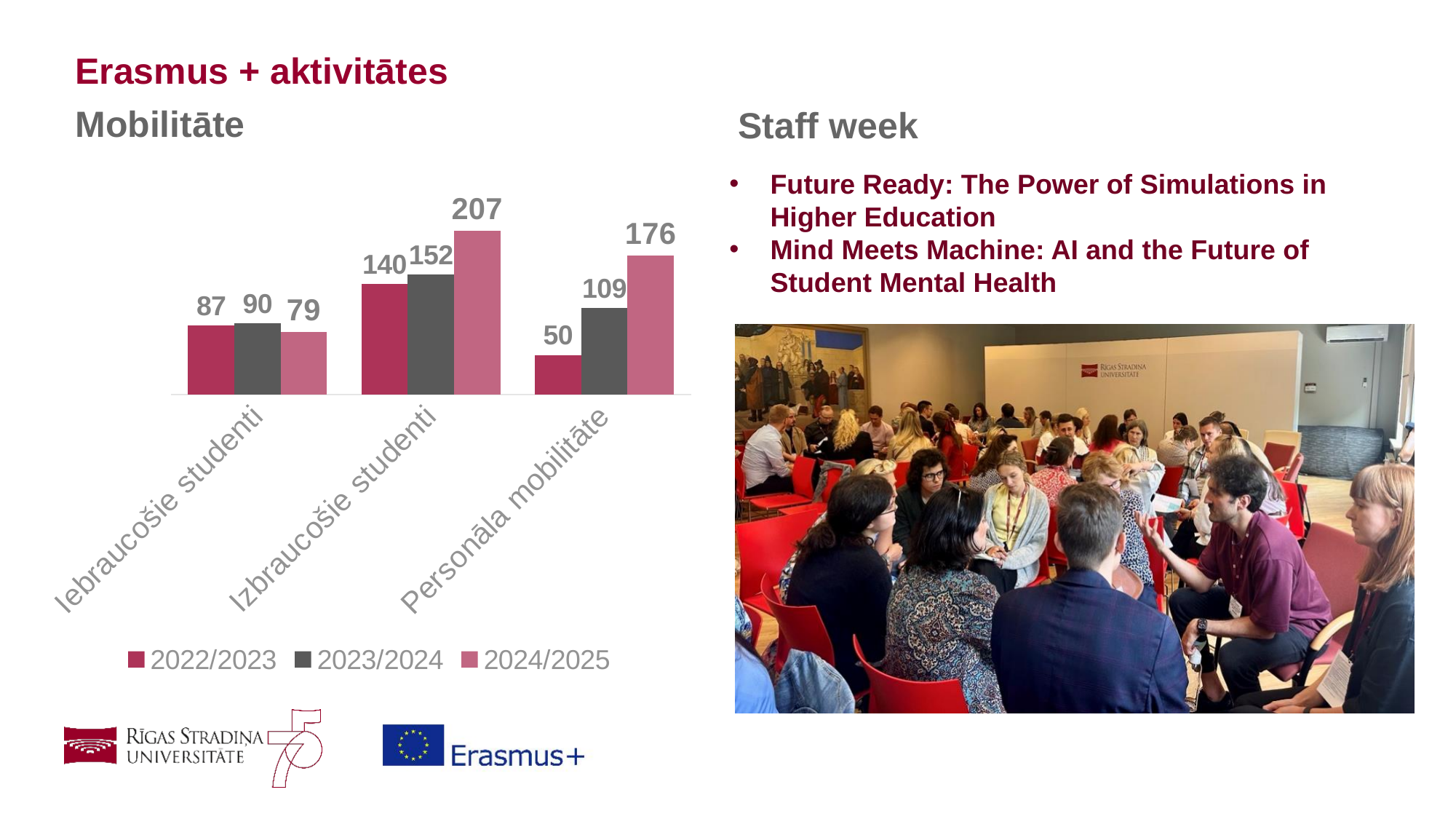
Which category has the highest value in the 2024/2025 series? Izbraucošie studenti What is the value for Personāla mobilitāte in 2022/2023? 50 What is the value for Izbraucošie studenti in 2024/2025? 207 Which is larger for Iebraucošie studenti: the 2023/2024 value or the 2024/2025 value? 2023/2024 What kind of chart is shown on the slide? Bar chart How many series does the chart legend list? 3 How many categories are shown on the x axis of the chart? 3 Which category has the lowest value in the 2022/2023 series? Personāla mobilitāte Do the values for Personāla mobilitāte rise or fall from 2022/2023 to 2024/2025? Rise What is the value for Iebraucošie studenti in 2023/2024? 90 What is the difference between the 2024/2025 and 2022/2023 values for Personāla mobilitāte? 126 What is the title shown above the chart? Mobilitāte